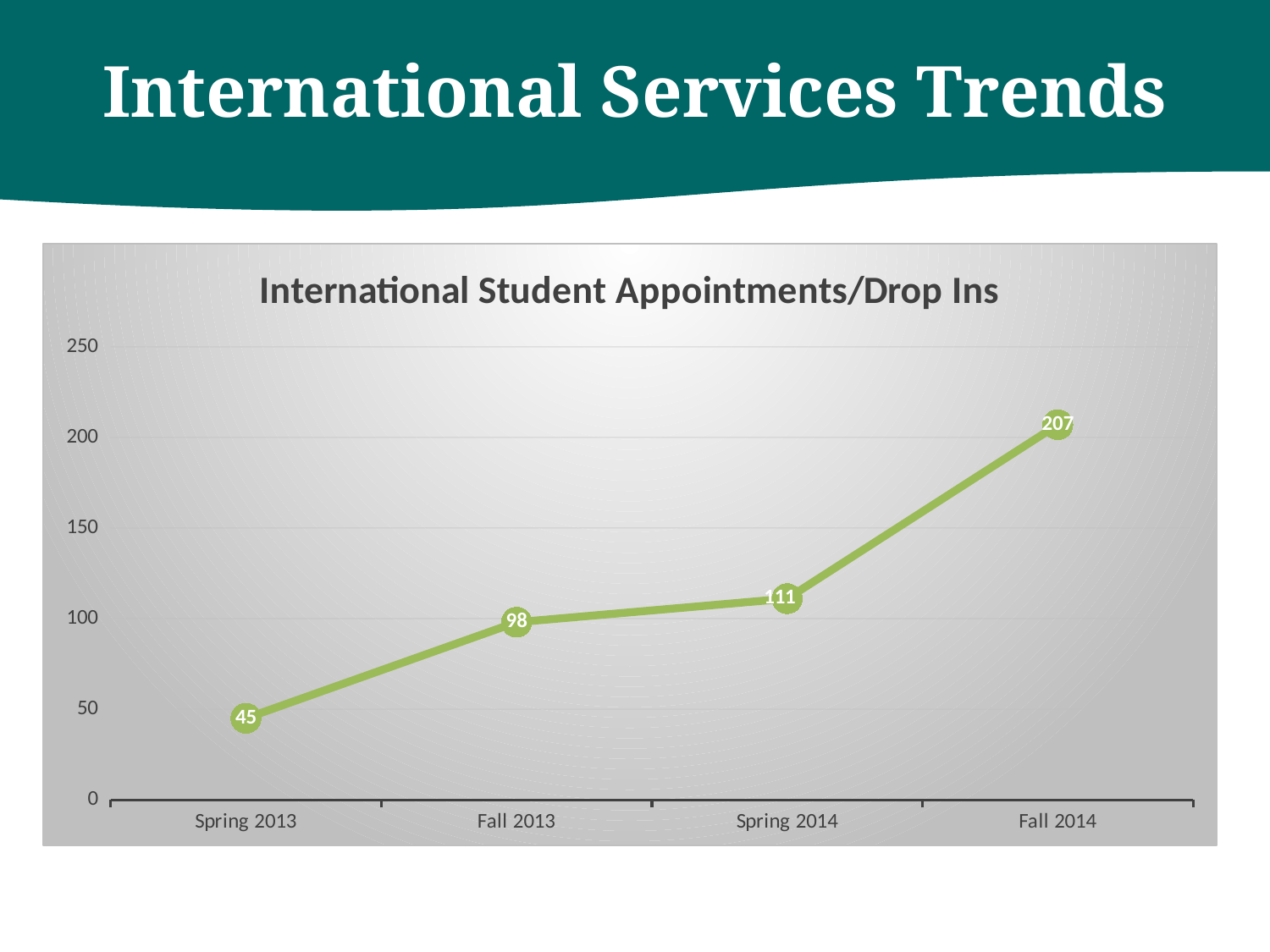
Is the value for Fall 2014 greater or less than 200? greater What is the value for Fall 2013? 98 What is the value for Spring 2014? 111 What is the value for Fall 2014? 207 Which period has the lowest value? Spring 2013 What kind of chart is shown? line chart Which period has the highest value? Fall 2014 Do the values rise or fall from Spring 2013 to Fall 2014? rise Which is larger, the value for Fall 2013 or the value for Spring 2014? Spring 2014 What is the difference between the values for Fall 2014 and Spring 2014? 96 How many periods are plotted on the x axis? 4 What is the value for Spring 2013? 45